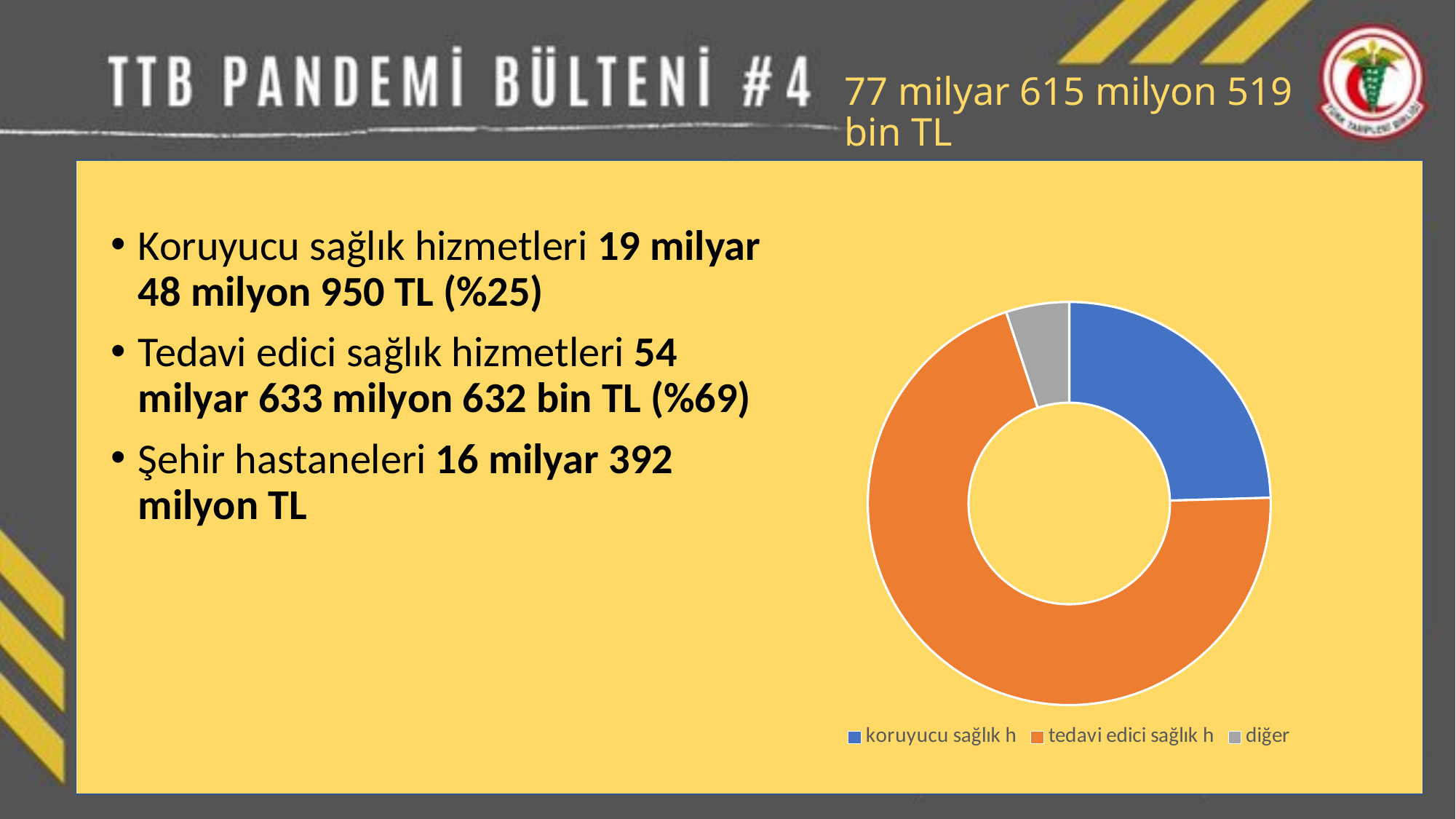
What share of the total do koruyucu sağlık hizmetleri represent, according to the slide? %25 How many slices does the doughnut chart have? 3 Which slice is larger: tedavi edici sağlık h or koruyucu sağlık h? tedavi edici sağlık h Which category has the largest slice in the doughnut chart? tedavi edici sağlık h What share of the total do tedavi edici sağlık hizmetleri represent, according to the slide? %69 What colour is the tedavi edici sağlık h slice in the chart? orange How many entries does the chart legend list? 3 What kind of chart is shown on the slide? doughnut (pie) chart Which category has the smallest slice in the doughnut chart? diğer What colour is the koruyucu sağlık h slice in the chart? blue Which slice is larger: koruyucu sağlık h or diğer? koruyucu sağlık h Does the tedavi edici sağlık h slice cover more or less than half of the doughnut? more